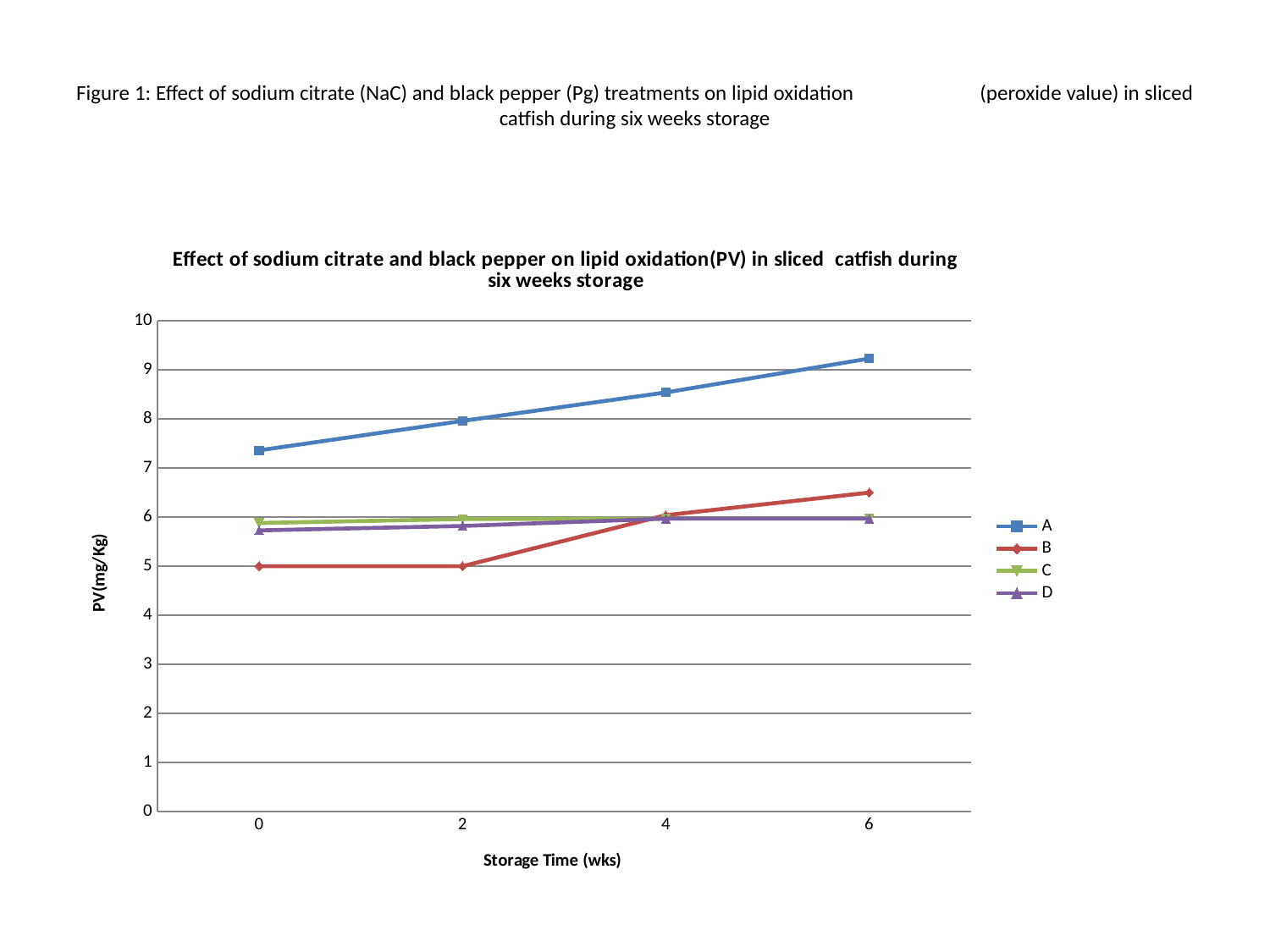
What is the label of the y axis? PV(mg/Kg) Does the PV value for series A rise or fall as storage time increases from 0 to 6 weeks? rise Is the PV value for series A at 0 weeks greater or less than 7? greater Which series has the highest PV value at 6 weeks of storage? A How many series does the legend list? 4 Is the PV value for series A at 6 weeks greater or less than 9? greater Which is larger at 6 weeks: the PV value for series A or series B? A Is the PV value for series B at 6 weeks greater or less than 7? less What kind of chart is shown on the slide? line chart What is the PV value for series B at 0 weeks of storage? 5 How many storage time points are plotted along the x axis? 4 Which series has the lowest PV value at 0 weeks of storage? B